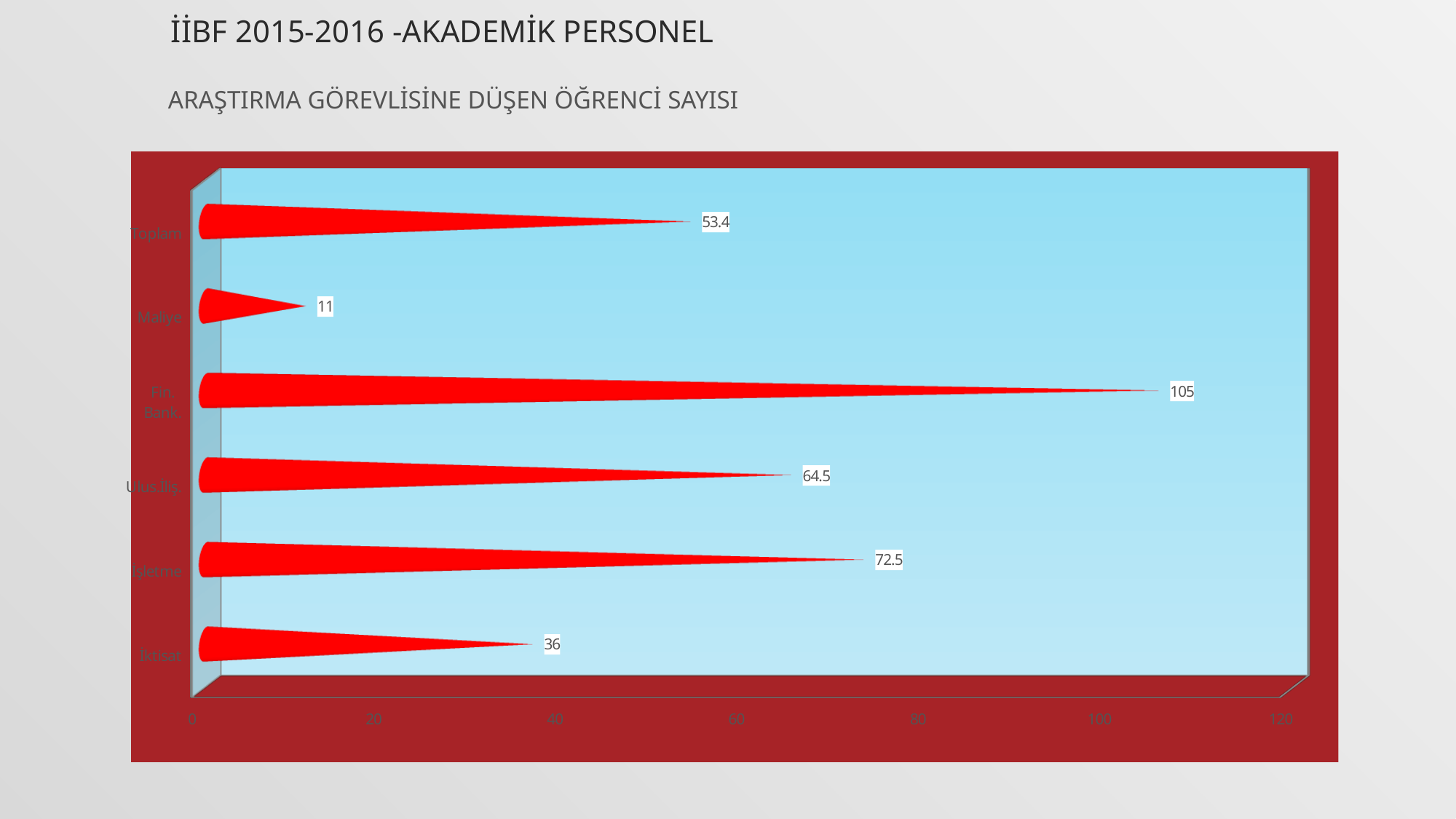
What kind of chart is shown on the slide? bar chart Is the value for Ulus.İliş. greater or less than 60? greater What is the value for İşletme? 72.5 Which category has the lowest value? Maliye Which category has the highest value? Fin. Bank. What is the difference between the values for İşletme and Ulus.İliş.? 8 What is the difference between the values for Fin. Bank. and İktisat? 69 How many categories are shown on the chart? 6 What is the value for Fin. Bank.? 105 Which is larger, the value for İktisat or the value for Toplam? Toplam What is the value for Maliye? 11 What is the value for Toplam? 53.4